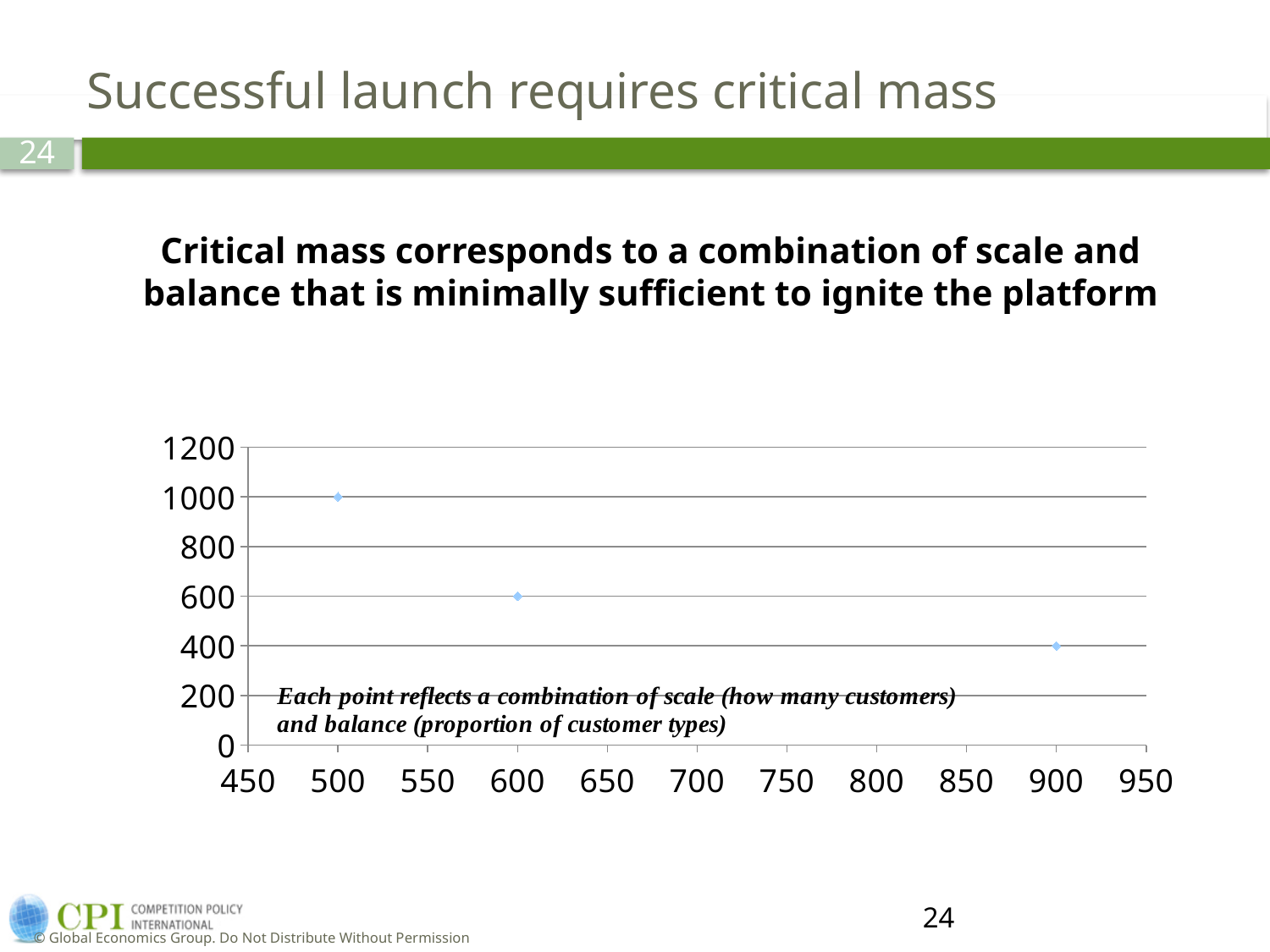
What is the y value of the point at x = 600? 600 What kind of chart is shown on the slide? scatter chart Which x value has the highest y value? 500 How many data points are plotted on the chart? 3 Do the y values rise or fall as x increases along the x axis? fall What is the maximum value shown on the y axis? 1200 Is the y value of the point at x = 900 greater or less than 600? less Which has a larger y value, the point at x = 600 or the point at x = 900? x = 600 What is the difference between the y values at x = 500 and x = 900? 600 What is the y value of the point at x = 900? 400 Which x value has the lowest y value? 900 What is the y value of the point at x = 500? 1000